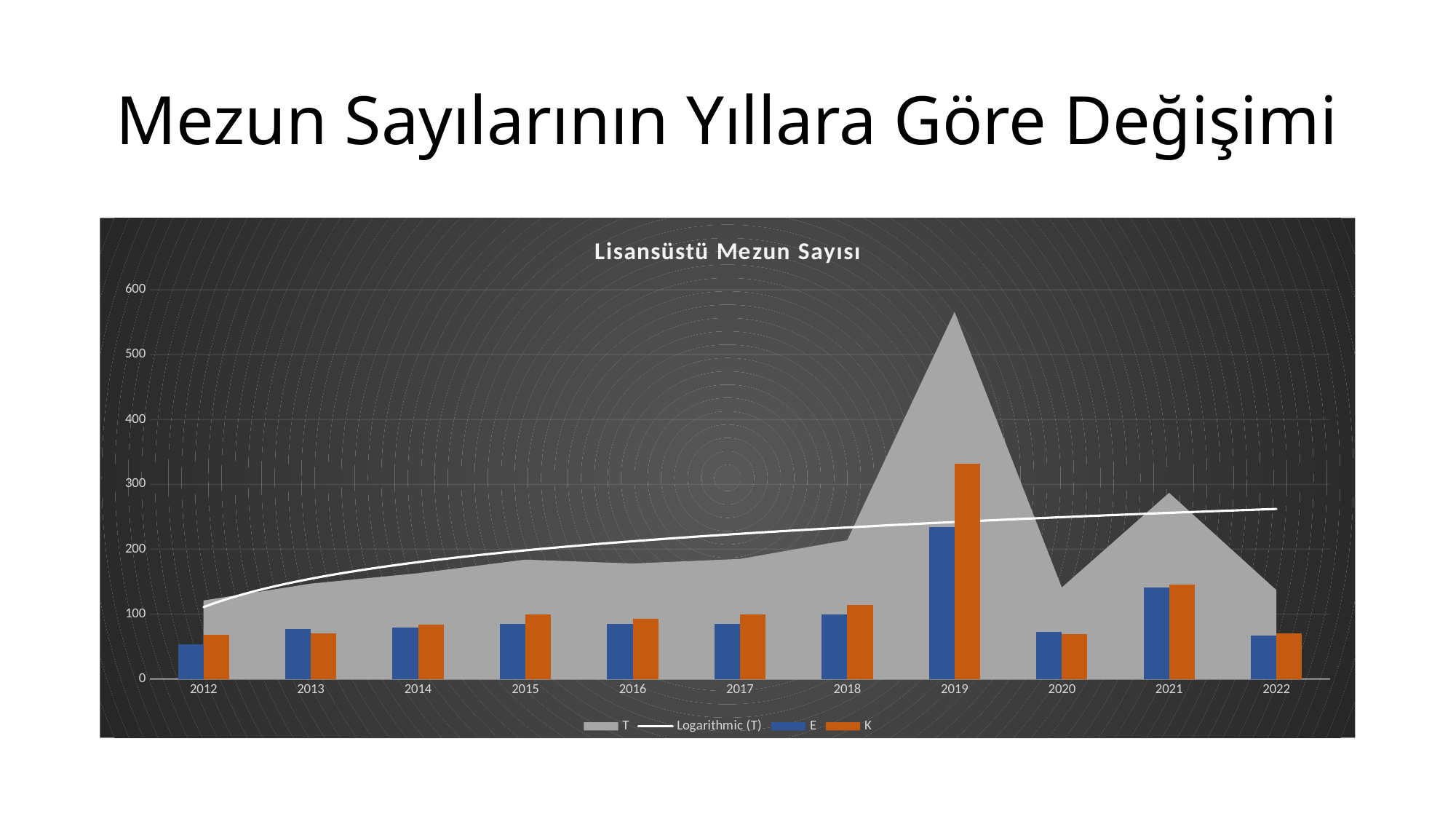
How many series does the chart legend list? 4 In 2019, which is larger, the E bar or the K bar? K In which year does the T series reach its highest value? 2019 In which year is the K bar the tallest? 2019 How many years are shown on the x axis of the chart? 11 Does the T series rise or fall from 2019 to 2020? fall Is the value of T in 2019 greater or less than 500? greater Which legend entry is drawn as a white line? Logarithmic (T) In which year is the E bar the shortest? 2012 Is the value of K in 2019 greater or less than 300? greater Is the value of E in 2012 greater or less than 100? less What is the title of the chart? Lisansüstü Mezun Sayısı